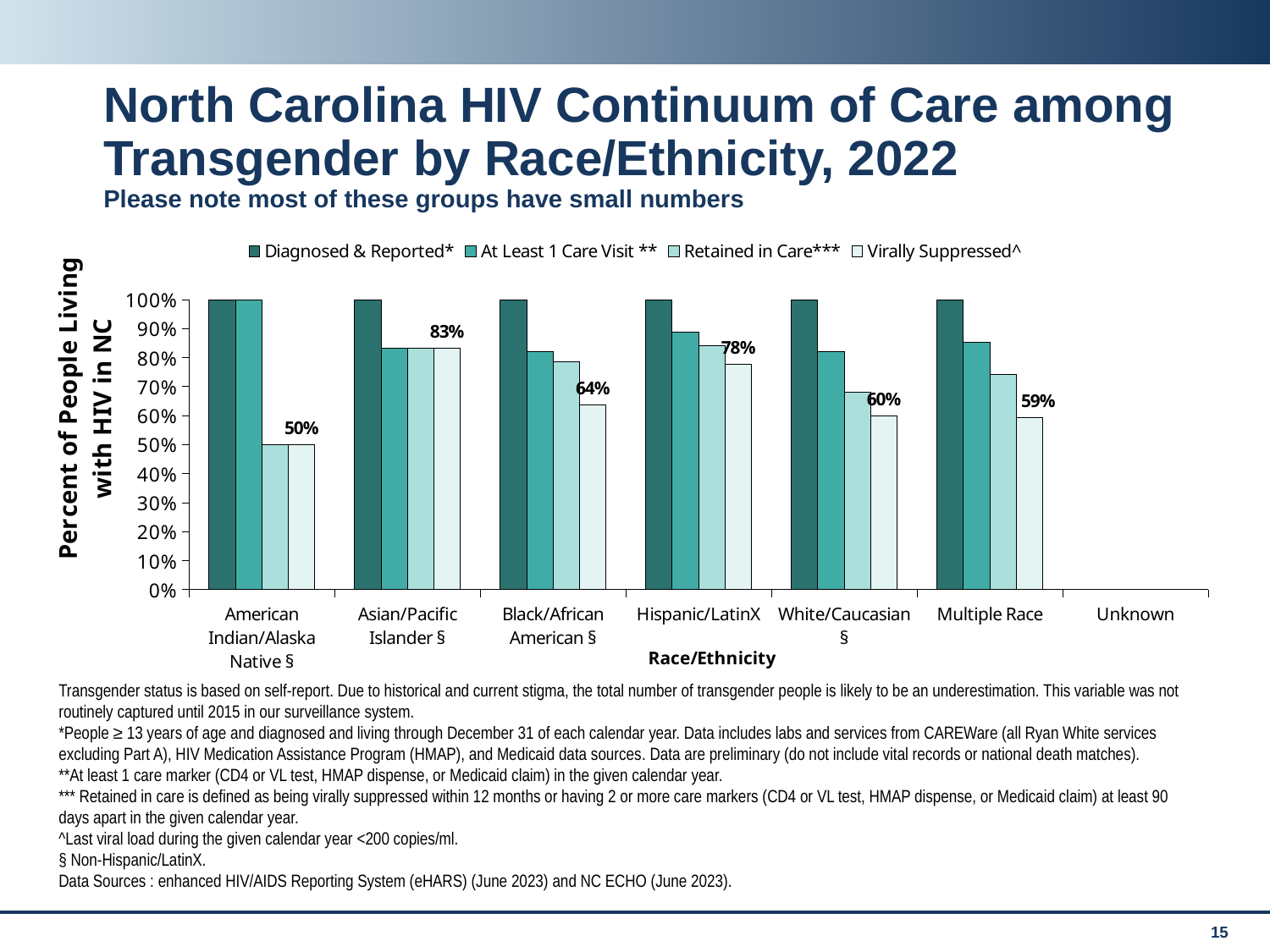
How many series does the legend list? 4 Which has a higher Virally Suppressed^ value, Black/African American § or White/Caucasian §? Black/African American § Which race/ethnicity group has the lowest Virally Suppressed^ value among groups with bars shown? American Indian/Alaska Native § Is the At Least 1 Care Visit ** value for Hispanic/LatinX greater or less than 80%? greater Which race/ethnicity group has the highest Virally Suppressed^ value? Asian/Pacific Islander § What is the Diagnosed & Reported* value for Multiple Race? 100% What is the Virally Suppressed^ value for Hispanic/LatinX? 78% Is the Retained in Care*** value for American Indian/Alaska Native § greater or less than 60%? less What is the title of the y axis? Percent of People Living with HIV in NC What is the Virally Suppressed^ value for American Indian/Alaska Native §? 50% What is the difference between the Virally Suppressed^ values for Hispanic/LatinX and White/Caucasian §? 18 percentage points What is the Virally Suppressed^ value for Asian/Pacific Islander §? 83%